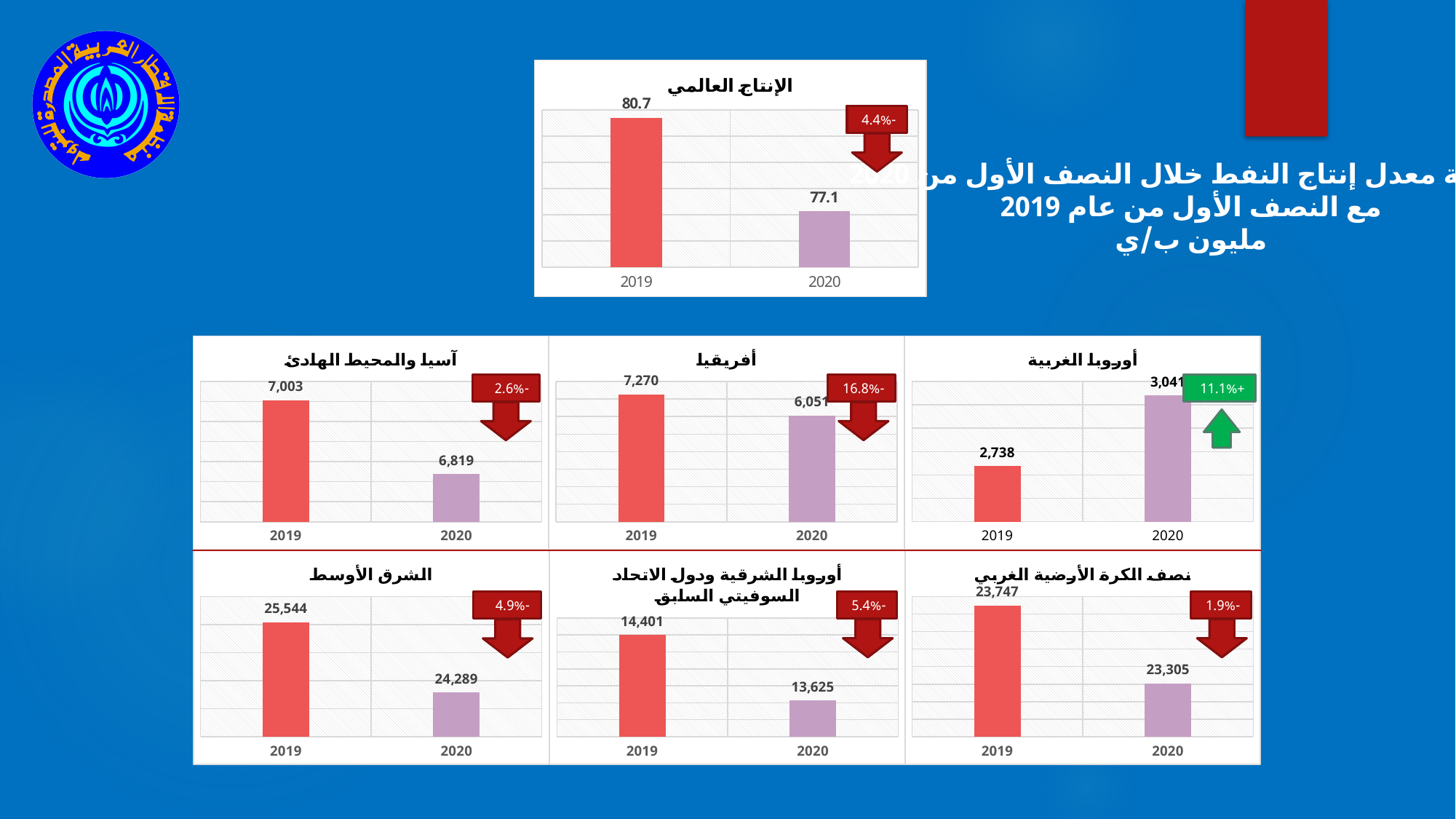
In the chart titled "نصف الكرة الأرضية الغربي" (bottom-right of the grid), do the values rise or fall from 2019 to 2020? fall In the chart titled "الإنتاج العالمي" at the top of the slide, what is the value for 2019? 80.7 In the chart titled "أوروبا الغربية", what is the value for 2020? 3,041 In the chart titled "أفريقيا", what is the difference between the 2019 and 2020 values? 1,219 What kind of chart is the one titled "الشرق الأوسط"? bar chart In the chart titled "الشرق الأوسط" (bottom-left of the grid), what is the value for 2019? 25,544 In the chart titled "أفريقيا" (top-middle of the grid), what is the value for 2019? 7,270 In the chart titled "أوروبا الشرقية ودول الاتحاد السوفيتي السابق" (bottom-middle of the grid), what is the value for 2020? 13,625 In the chart titled "الإنتاج العالمي" at the top of the slide, what is the value for 2020? 77.1 In the chart titled "آسيا والمحيط الهادئ" (top-left of the grid), what is the value for 2020? 6,819 In the chart titled "أوروبا الغربية" (top-right of the grid), which year has the higher value, 2019 or 2020? 2020 In the chart titled "الإنتاج العالمي", what is the difference between the 2019 and 2020 values? 3.6